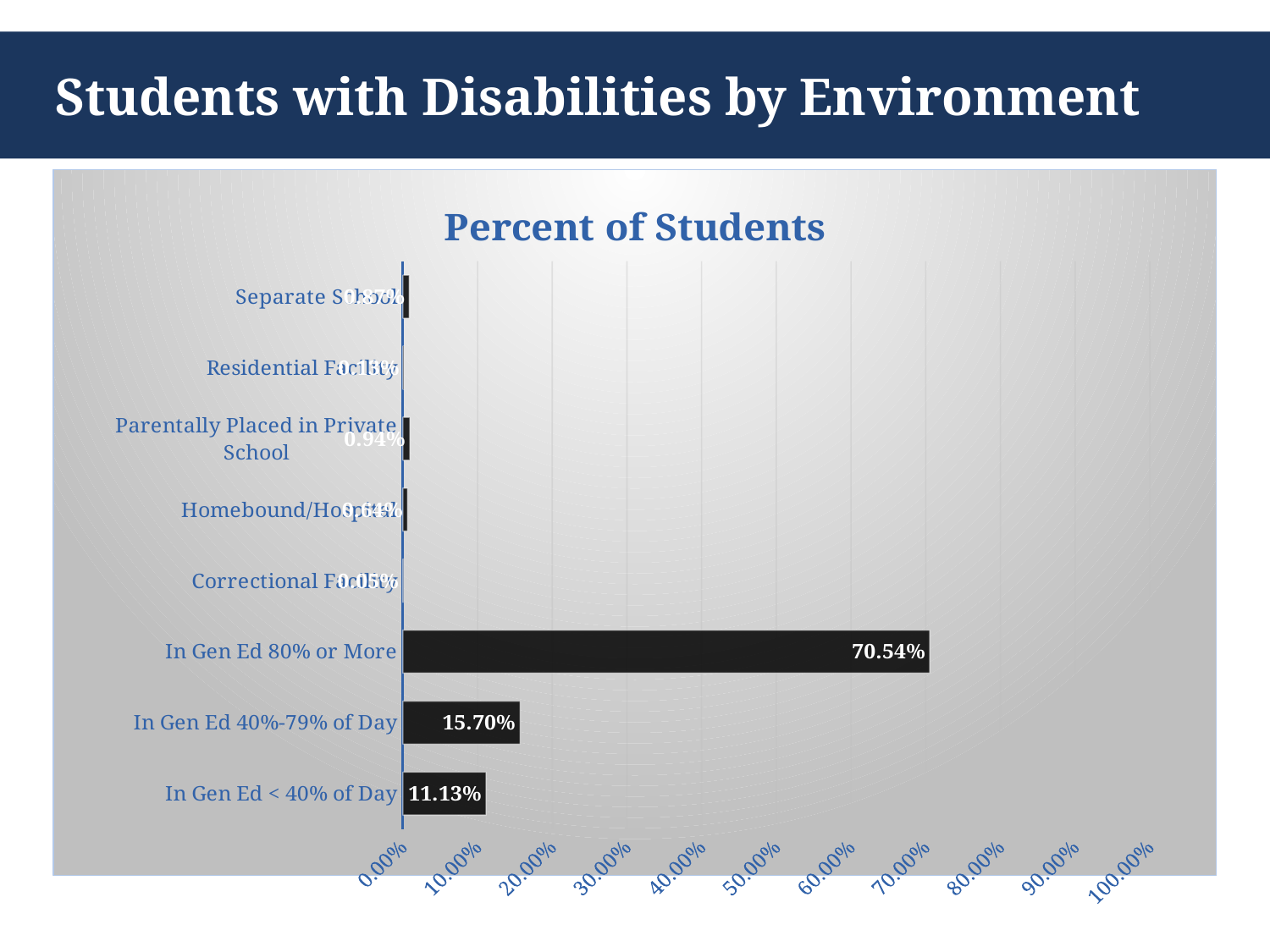
Which is larger, the value for In Gen Ed 40%-79% of Day or the value for In Gen Ed < 40% of Day? In Gen Ed 40%-79% of Day What is the value for In Gen Ed < 40% of Day? 11.13% What is the title of the chart? Percent of Students What is the difference between the values for In Gen Ed 80% or More and In Gen Ed 40%-79% of Day? 54.84% Is the value for In Gen Ed 80% or More greater or less than 60.00%? greater How many categories are plotted in the chart? 8 What type of chart is shown on the slide? Bar chart What is the value for Parentally Placed in Private School? 0.94% What is the value for In Gen Ed 40%-79% of Day? 15.70% Which category has the highest value? In Gen Ed 80% or More What is the difference between the values for In Gen Ed 40%-79% of Day and In Gen Ed < 40% of Day? 4.57% What is the value for In Gen Ed 80% or More? 70.54%